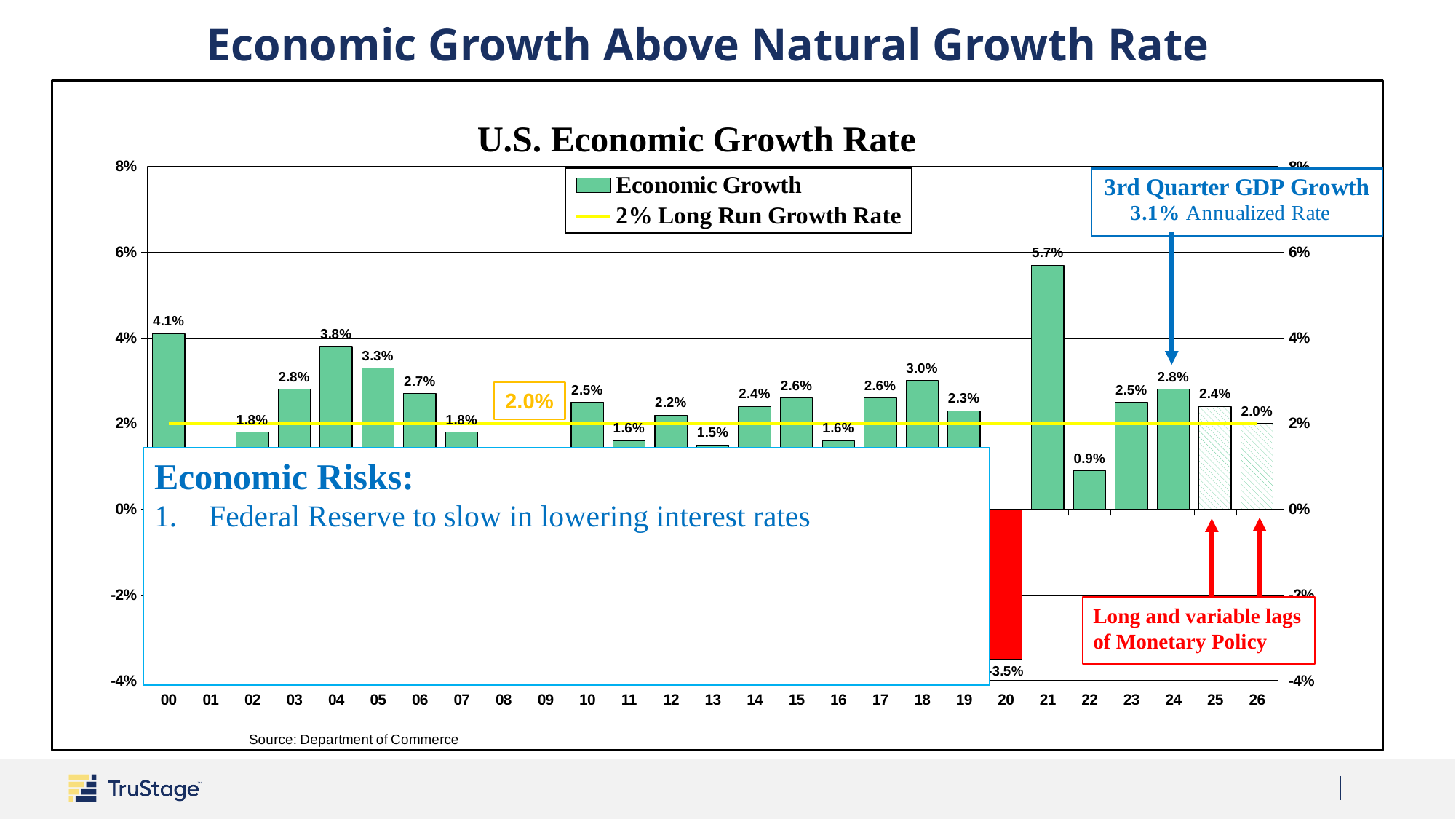
What is the title of the chart? U.S. Economic Growth Rate Which year has the lowest economic growth rate? 20 How many years are shown on the x axis? 27 Is the value for 22 greater or less than 2%? less What is the economic growth rate shown for 04? 3.8% Which year has the higher growth rate, 18 or 19? 18 What is the economic growth rate shown for 20? -3.5% What kind of chart is used to show the economic growth rate? bar chart Which year has the highest economic growth rate? 21 How many series does the legend list? 2 What is the difference between the growth rates for 21 and 22? 4.8 percentage points What is the economic growth rate shown for 21? 5.7%